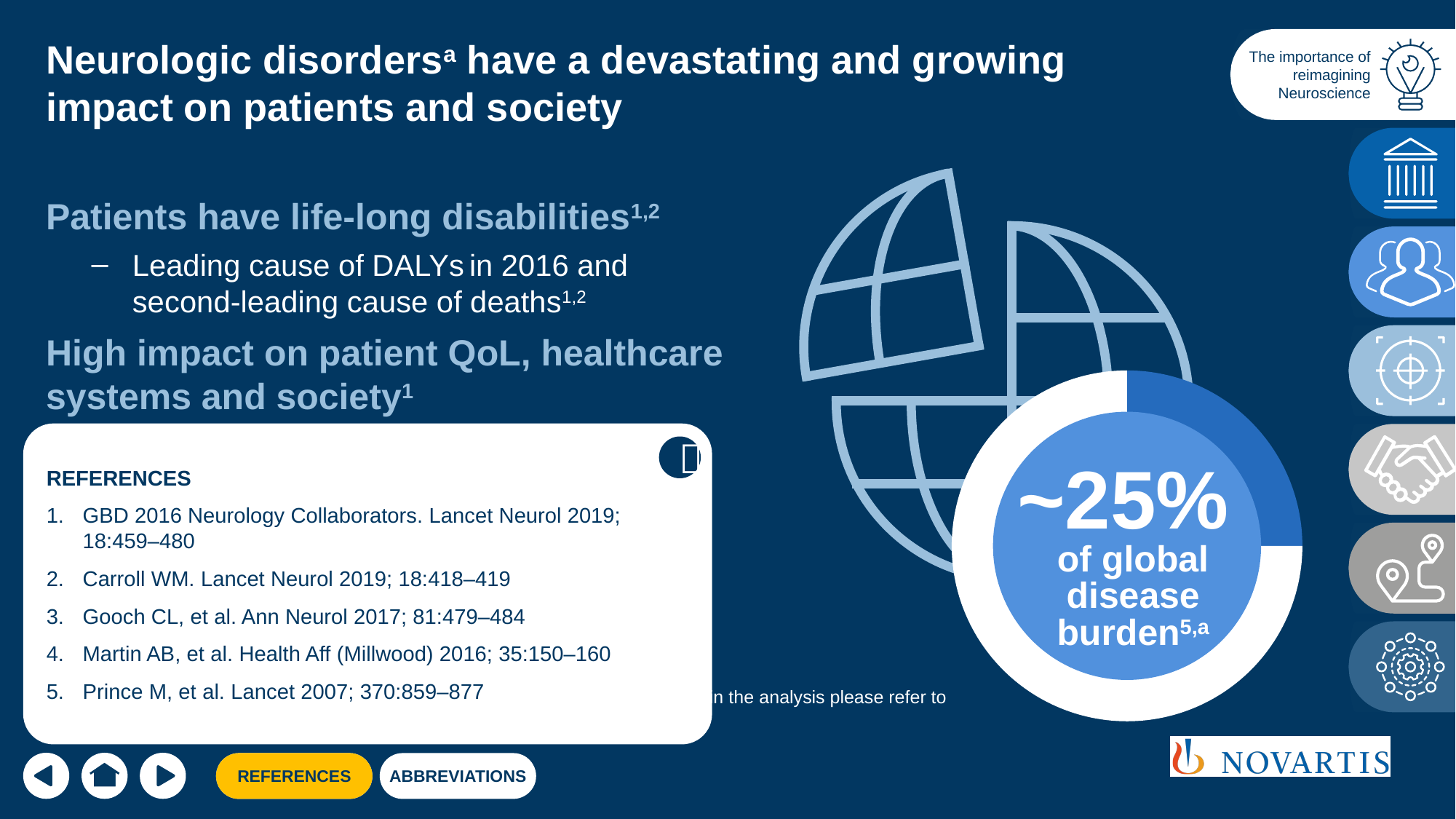
What does the value in the donut chart represent, according to the text inside it? of global disease burden Which reference numbers are cited for the ~25% figure in the donut chart? 5,a How many highlighted segments does the donut chart show? 1 What share of global disease burden does the donut chart attribute to neurologic disorders? ~25% What kind of chart is shown on the right of the slide inside the globe graphic? Donut (pie) chart What value is printed in the centre of the donut chart? ~25%